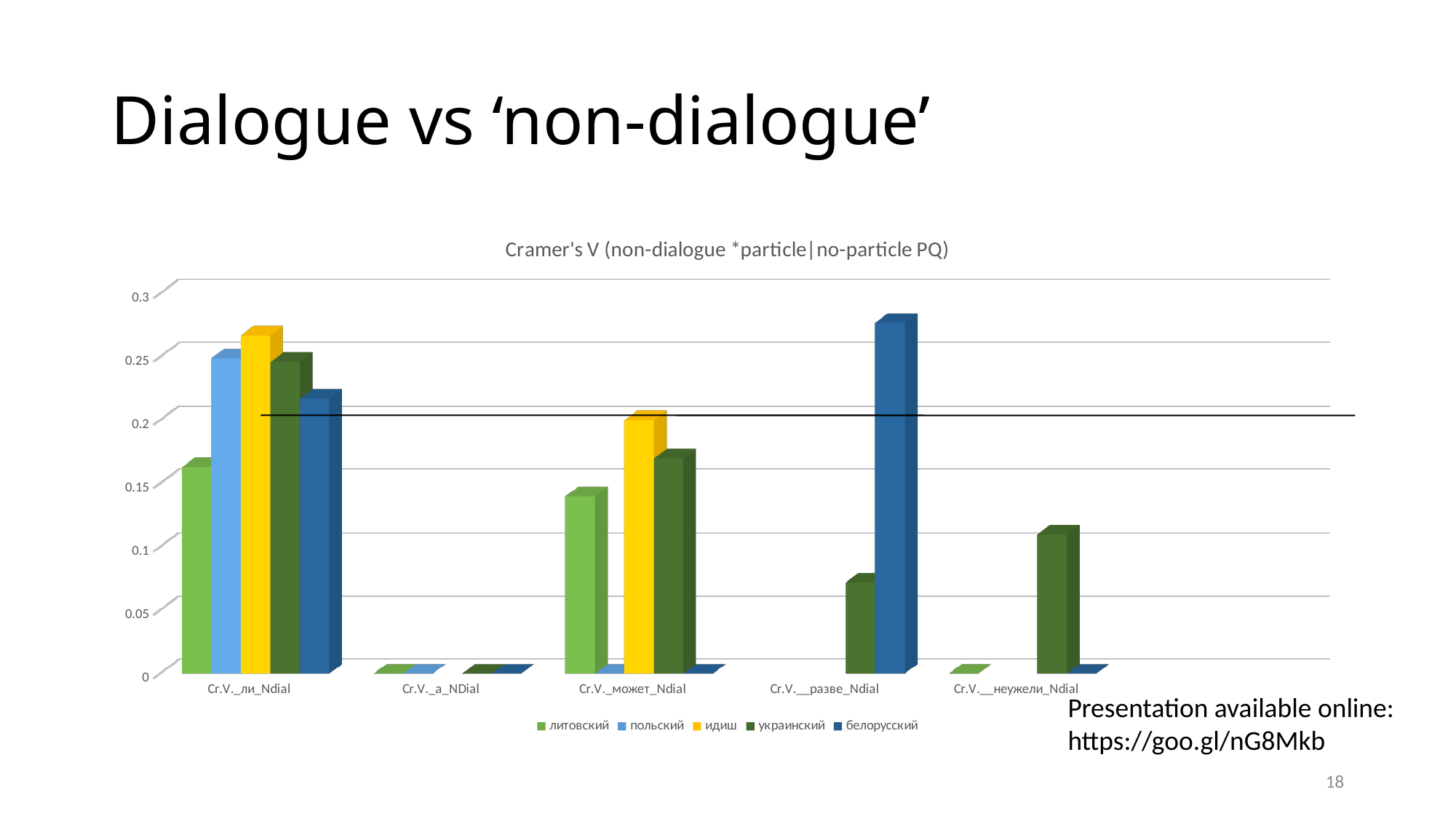
What is the title of the chart? Cramer's V (non-dialogue *particle|no-particle PQ) Is the value for белорусский in the category Cr.V.__разве_Ndial greater or less than 0.25? greater Which series has the highest value for the category Cr.V._ли_Ndial? идиш In the category Cr.V.__разве_Ndial, which is larger: the value for белорусский or the value for украинский? белорусский How many categories are shown along the x axis of the chart? 5 For which category is the белорусский series highest? Cr.V.__разве_Ndial How many series does the chart's legend list? 5 Is the value for украинский in the category Cr.V.__разве_Ndial greater or less than 0.1? less In the category Cr.V._может_Ndial, which is larger: the value for идиш or the value for литовский? идиш Is the value for литовский in the category Cr.V._ли_Ndial greater or less than 0.1? greater What kind of chart is shown on the slide? bar chart